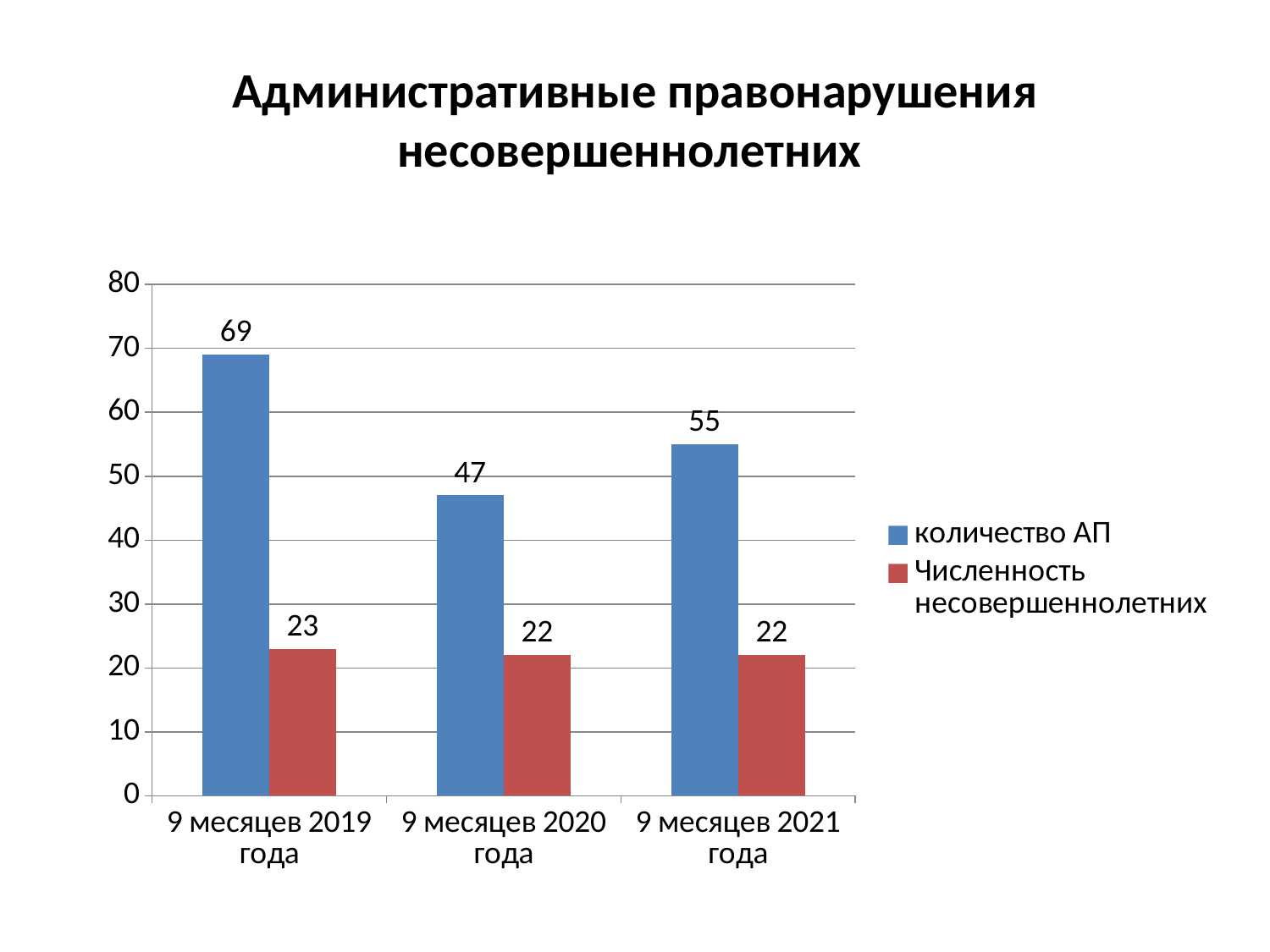
Is the value of "количество АП" for "9 месяцев 2020 года" greater or less than 50? less Which is larger: "количество АП" for "9 месяцев 2021 года" or for "9 месяцев 2020 года"? 9 месяцев 2021 года In which period is "количество АП" highest? 9 месяцев 2019 года How many series does the legend list? 2 What is the title of the chart? Административные правонарушения несовершеннолетних What kind of chart is shown on the slide? bar chart What is the value of "Численность несовершеннолетних" for "9 месяцев 2020 года"? 22 In which period is "количество АП" lowest? 9 месяцев 2020 года How many periods are shown on the x axis? 3 What is the value of "количество АП" for "9 месяцев 2021 года"? 55 What is the value of "количество АП" for "9 месяцев 2019 года"? 69 What is the difference between "количество АП" for "9 месяцев 2019 года" and "9 месяцев 2020 года"? 22